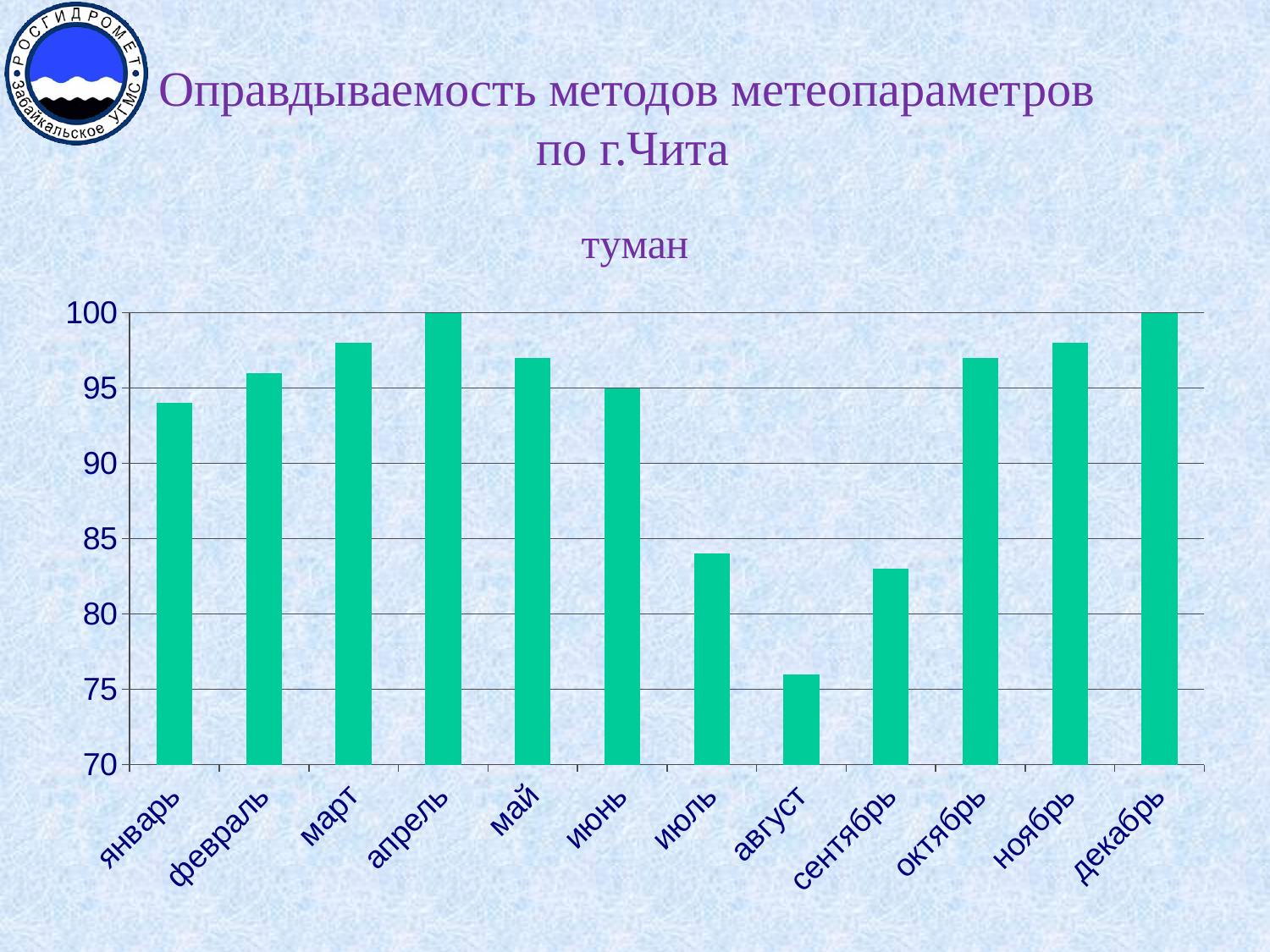
Which month has the lowest value? август Which is larger, the value for сентябрь or the value for октябрь? октябрь What is the value for апрель? 100 Is the value for июль greater or less than 90? less What is the value for декабрь? 100 What is the value for июнь? 95 Is the value for август greater or less than 80? less Is the value for март greater or less than 95? greater What kind of chart is shown on the slide? bar chart How many months are shown on the x axis of the chart? 12 Which is larger, the value for июль or the value for август? июль What is the title of the chart? туман